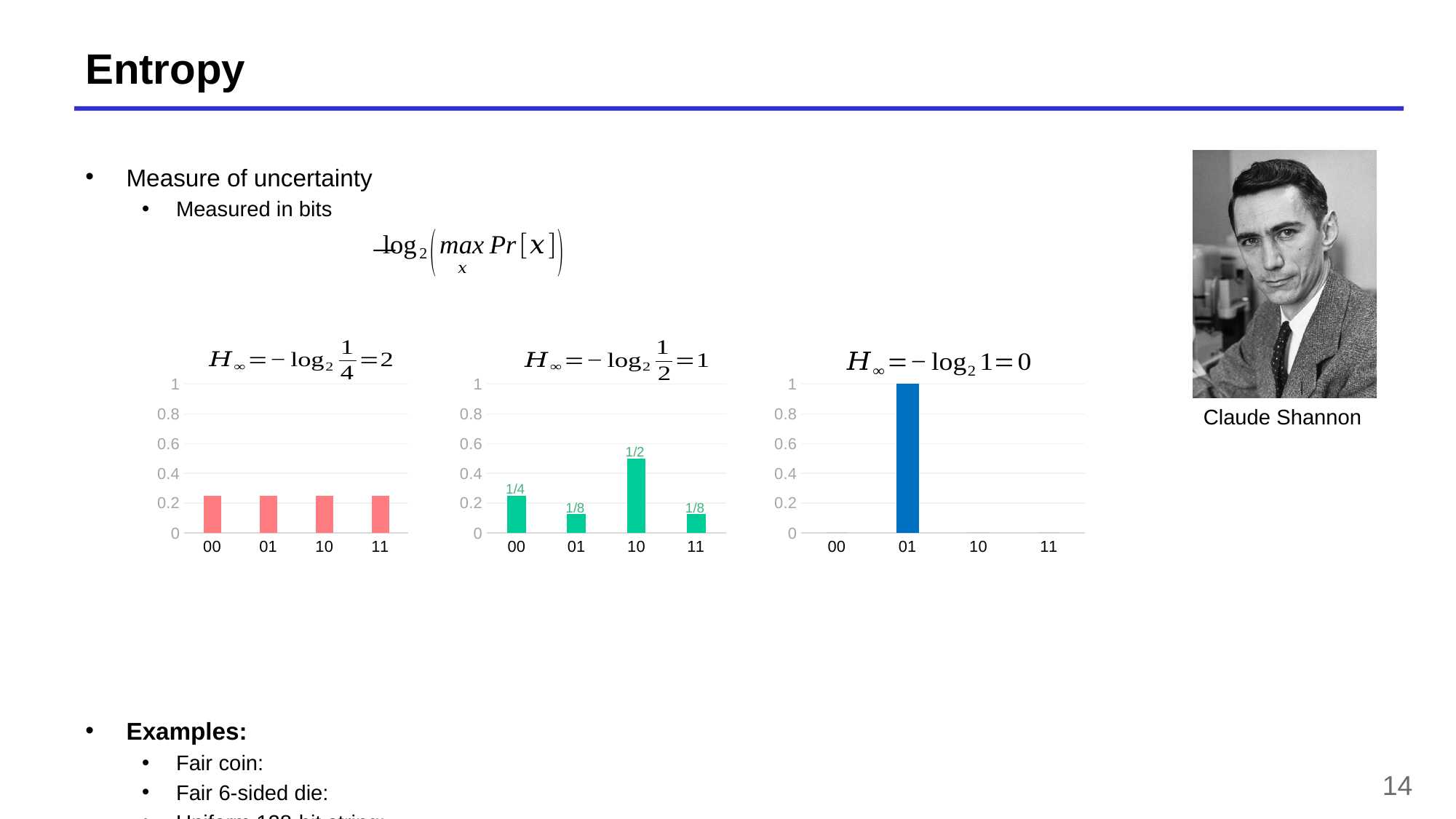
In the left chart, is the value for 11 greater or less than 0.2? greater In the left chart, is the value for 00 greater or less than 0.4? less In the middle chart, which category has the highest value? 10 In the middle chart, what is the value for category 00? 1/4 In the middle chart, what is the value for category 11? 1/8 In the right chart, which category has the highest value? 01 In the middle chart, what is the value for category 10? 1/2 What kind of chart is the middle chart? bar chart In the right chart, what is the value for category 01? 1 What colour are the bars in the right chart? blue In the middle chart, is the value for 00 larger or smaller than the value for 01? larger How many categories are shown on the x axis of the left chart? 4